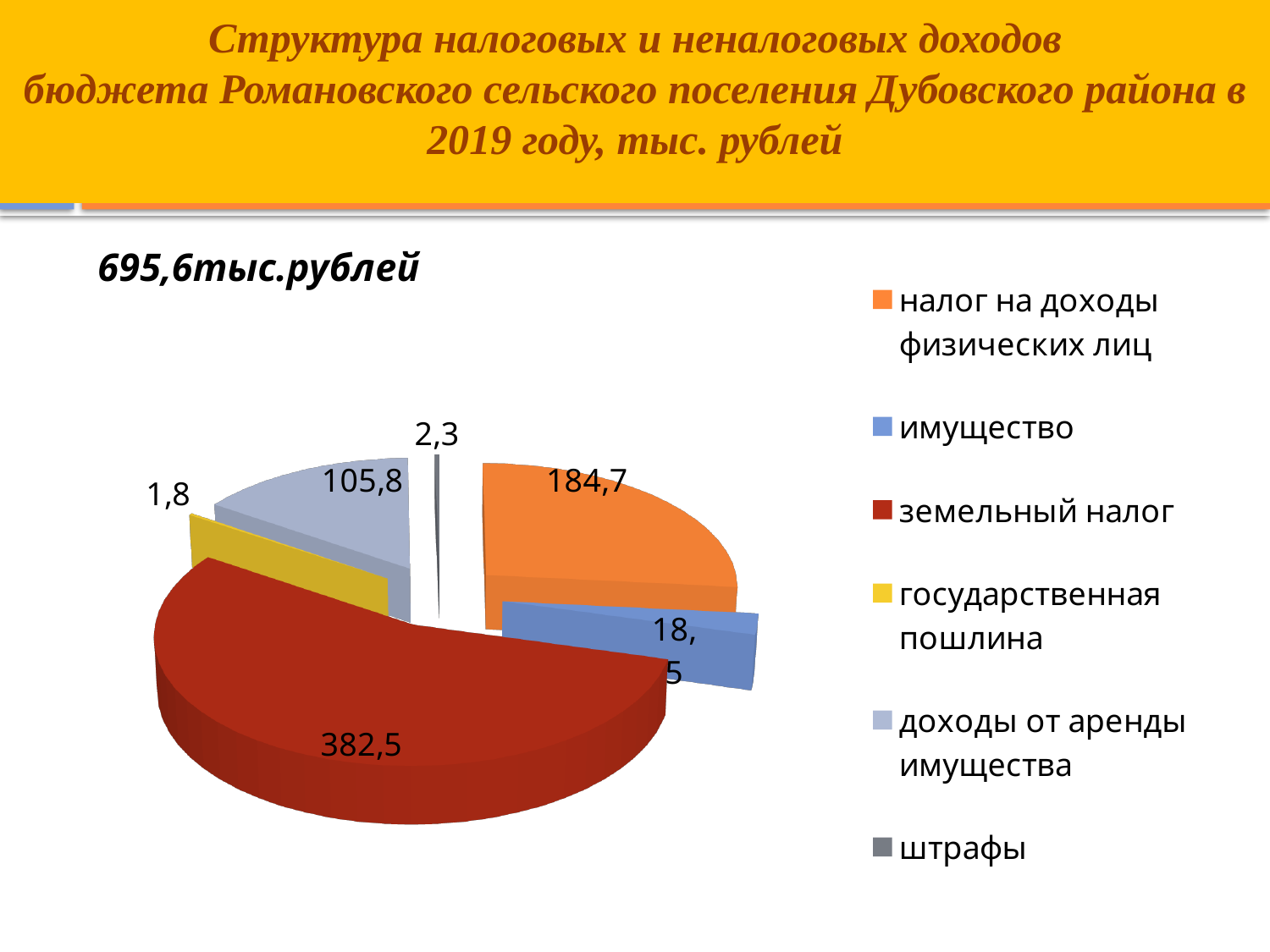
What is the value for земельный налог on the pie chart? 382,5 Which category has the largest slice of the pie chart? земельный налог What is the difference between the values for земельный налог and налог на доходы физических лиц? 197,8 Which category has the smallest slice of the pie chart? государственная пошлина What is the total of all slices shown on the pie chart, in тыс. рублей? 695,6 What colour is the slice for государственная пошлина? yellow How many categories does the pie chart show? 6 What is the value for доходы от аренды имущества on the pie chart? 105,8 What is the value for штрафы on the pie chart? 2,3 What type of chart is shown on the slide? pie chart Which is larger: имущество or доходы от аренды имущества? доходы от аренды имущества What is the value for налог на доходы физических лиц on the pie chart? 184,7